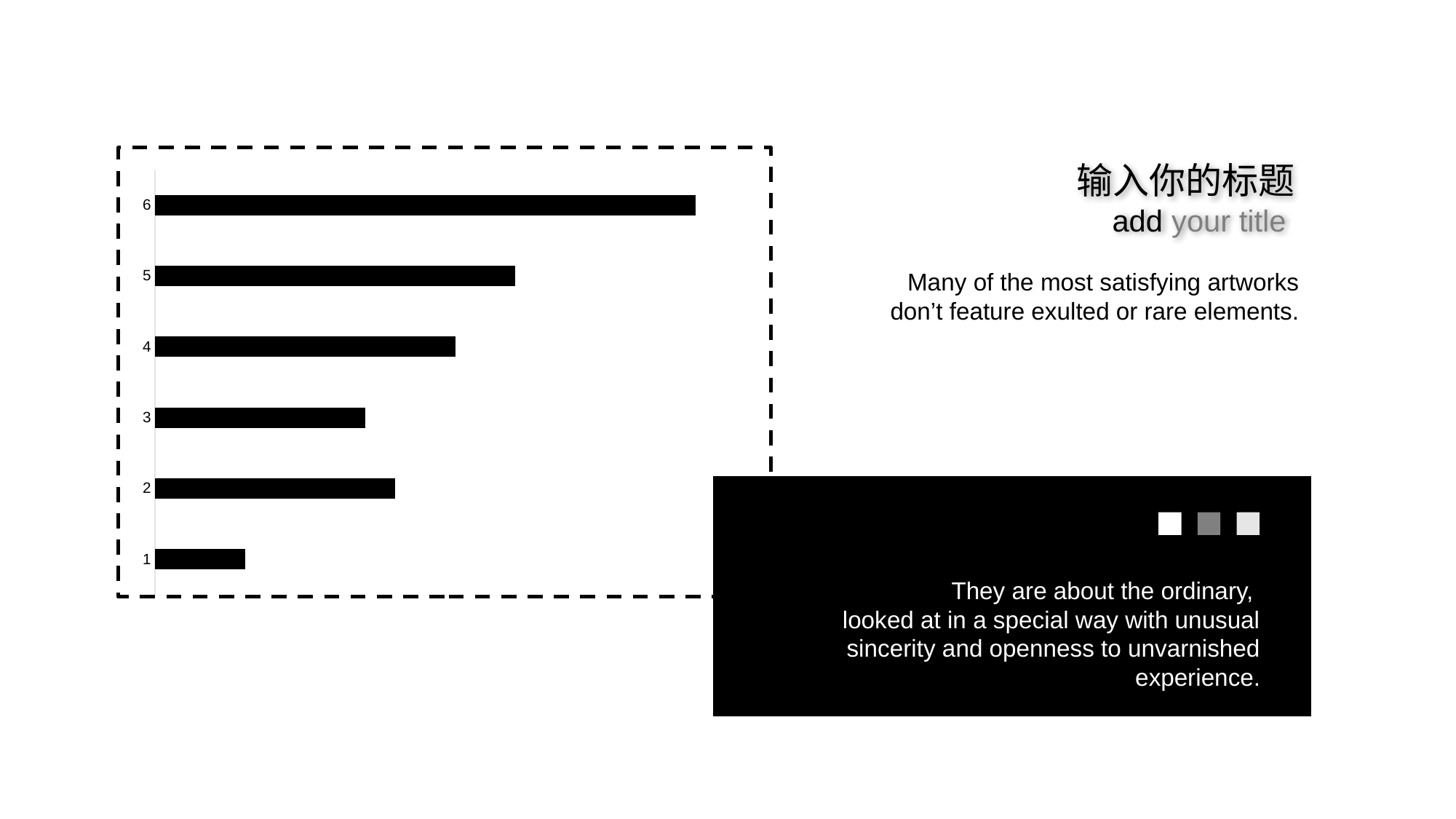
What kind of chart is shown on the slide? bar chart Are the bars in the chart drawn horizontally or vertically? horizontally Which has the larger value, category 6 or category 5? 6 Which category has the longest bar in the chart? 6 Which has the larger value, category 1 or category 2? 2 Which has the larger value, category 4 or category 3? 4 What colour are the bars in the chart? black How many categories are plotted in the bar chart? 6 Which category has the shortest bar in the chart? 1